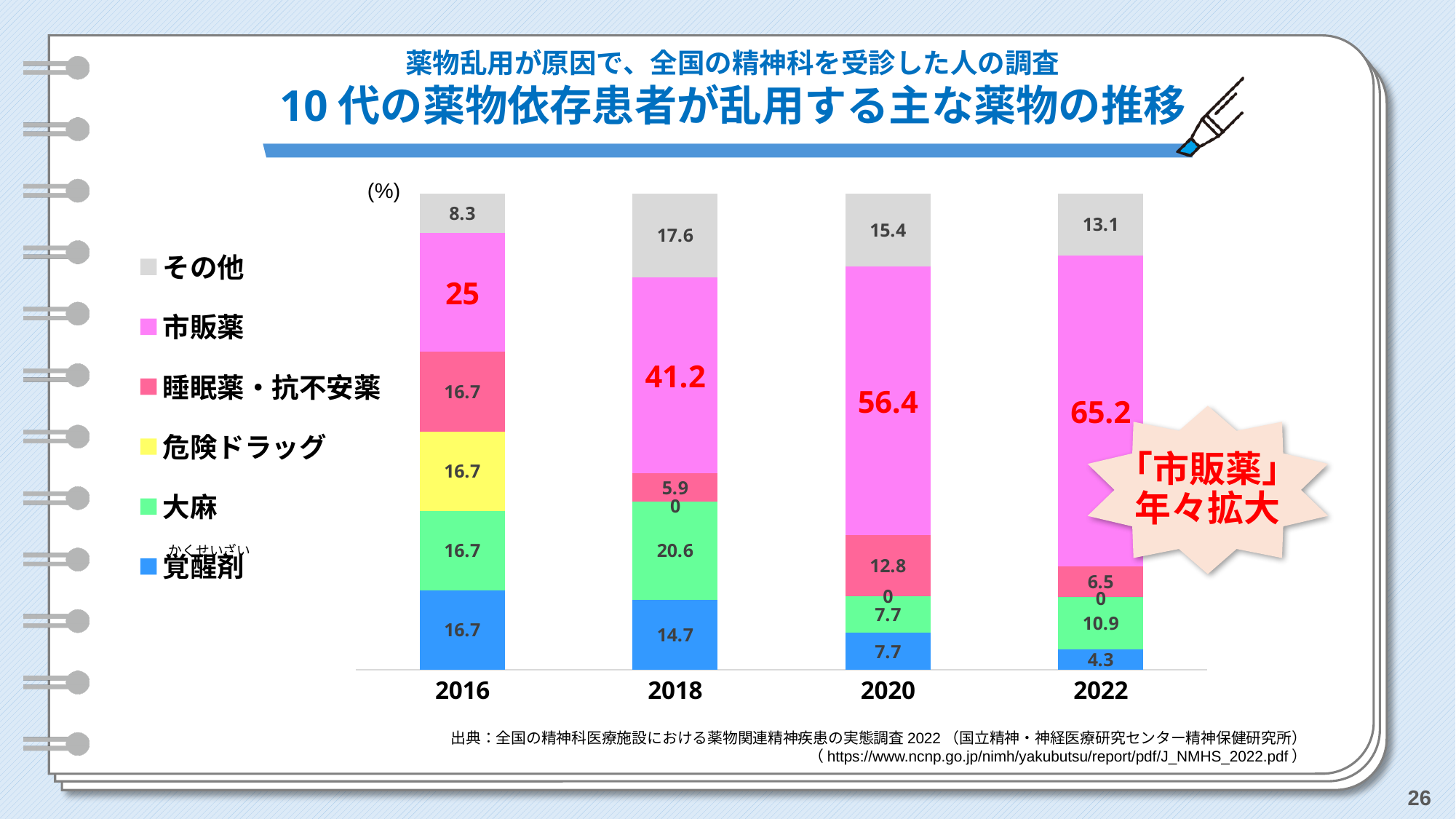
Which is larger, the value for 大麻 in 2018 or the value for 大麻 in 2022? 2018 In which year is the value for 覚醒剤 the lowest? 2022 How many years are shown on the x axis? 4 What is the value for 睡眠薬・抗不安薬 in 2020? 12.8 What is the value for 市販薬 in 2022? 65.2 What is the value for 覚醒剤 in 2018? 14.7 What is the value for その他 in 2016? 8.3 What is the difference between the 市販薬 values for 2022 and 2016? 40.2 In which year is the value for 市販薬 the highest? 2022 How many series does the legend list? 6 What kind of chart is shown on the slide? Stacked bar chart Does the value for 市販薬 rise or fall from 2016 to 2022? Rise